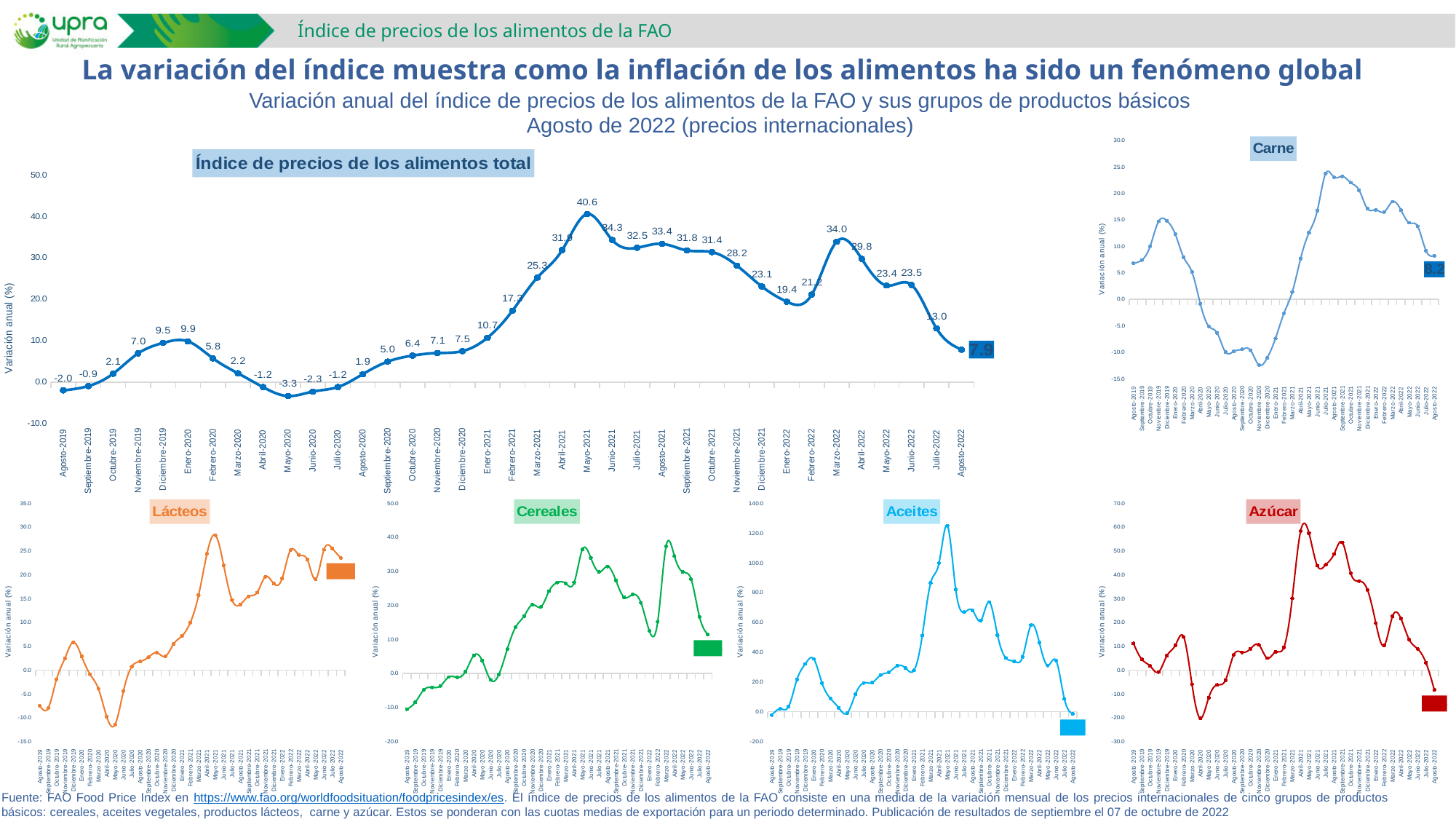
In the 'Azúcar' chart, is the value for Agosto-2022 greater or less than 0? less In the 'Aceites' chart, is the peak value in 2021 greater or less than 100? greater In the chart 'Índice de precios de los alimentos total', what is the value for Agosto-2022? 7.9 In the chart 'Índice de precios de los alimentos total', which month has the highest value? Mayo-2021 In the chart 'Índice de precios de los alimentos total', which month has the lowest value? Mayo-2020 How many commodity-group charts (besides the total index) are shown on the slide? 5 In the chart 'Índice de precios de los alimentos total', what is the value for Mayo-2021? 40.6 In the chart 'Índice de precios de los alimentos total', what is the difference between the values for Marzo-2022 and Abril-2022? 4.2 In the chart 'Índice de precios de los alimentos total', do the values rise or fall from Marzo-2022 to Agosto-2022? fall In the chart 'Índice de precios de los alimentos total', which is larger, the value for Febrero-2021 or the value for Diciembre-2021? Diciembre-2021 What kind of chart is used for 'Índice de precios de los alimentos total'? line chart In the chart 'Índice de precios de los alimentos total', how many monthly data points are plotted? 37